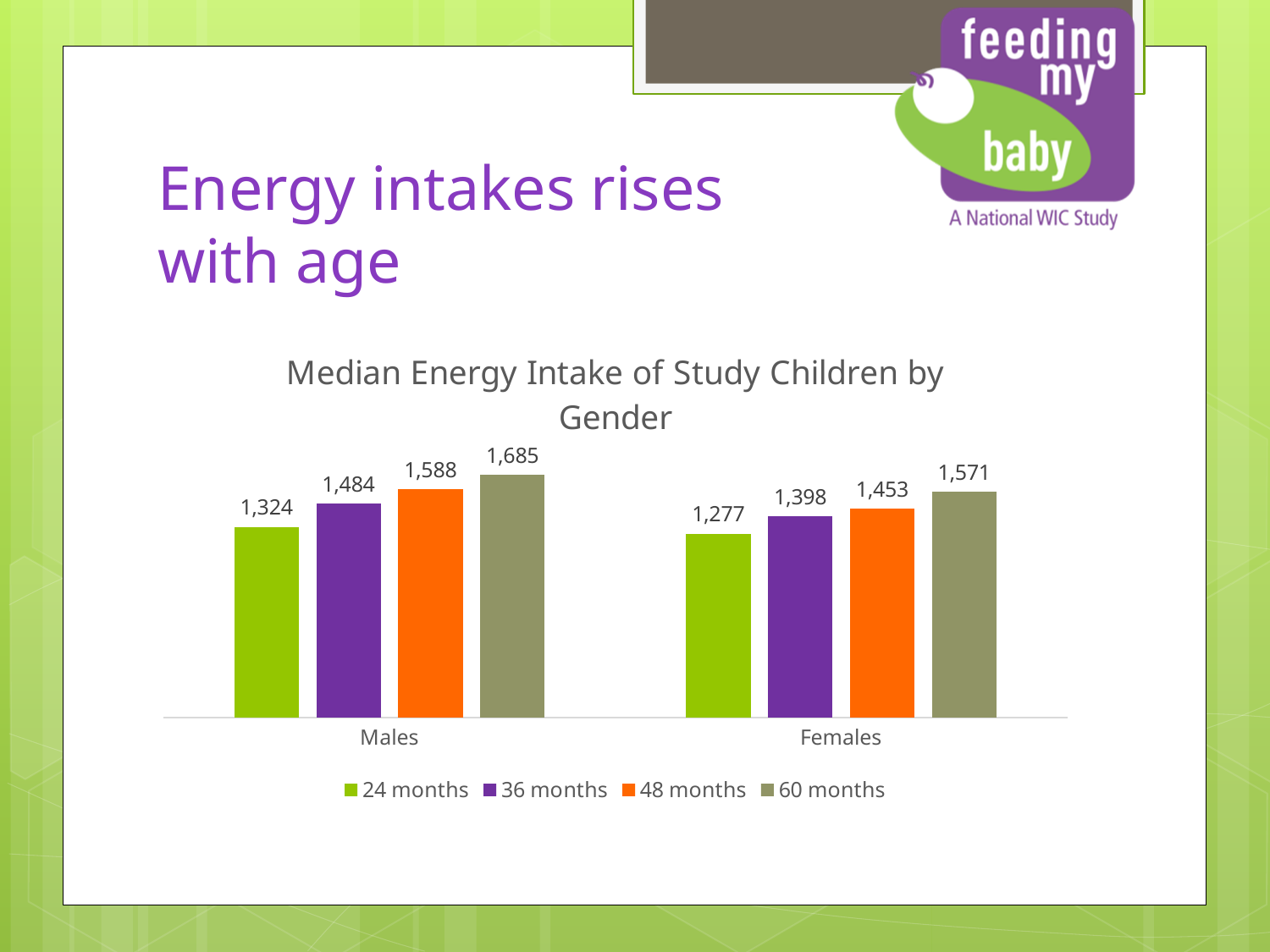
What is the median energy intake for Males at 24 months? 1,324 What is the difference between the Males and Females median energy intake at 36 months? 86 What is the difference between the 60 months and 24 months median energy intake for Males? 361 How many categories are shown on the x axis? 2 Which age group has the highest median energy intake for Males? 60 months How many series does the legend list? 4 Which age group has the lowest median energy intake for Females? 24 months What is the median energy intake for Females at 60 months? 1,571 Which is larger, the median energy intake for Males at 48 months or Females at 60 months? Males at 48 months What kind of chart is shown on the slide? Bar chart What is the median energy intake for Females at 48 months? 1,453 What is the title of the chart? Median Energy Intake of Study Children by Gender